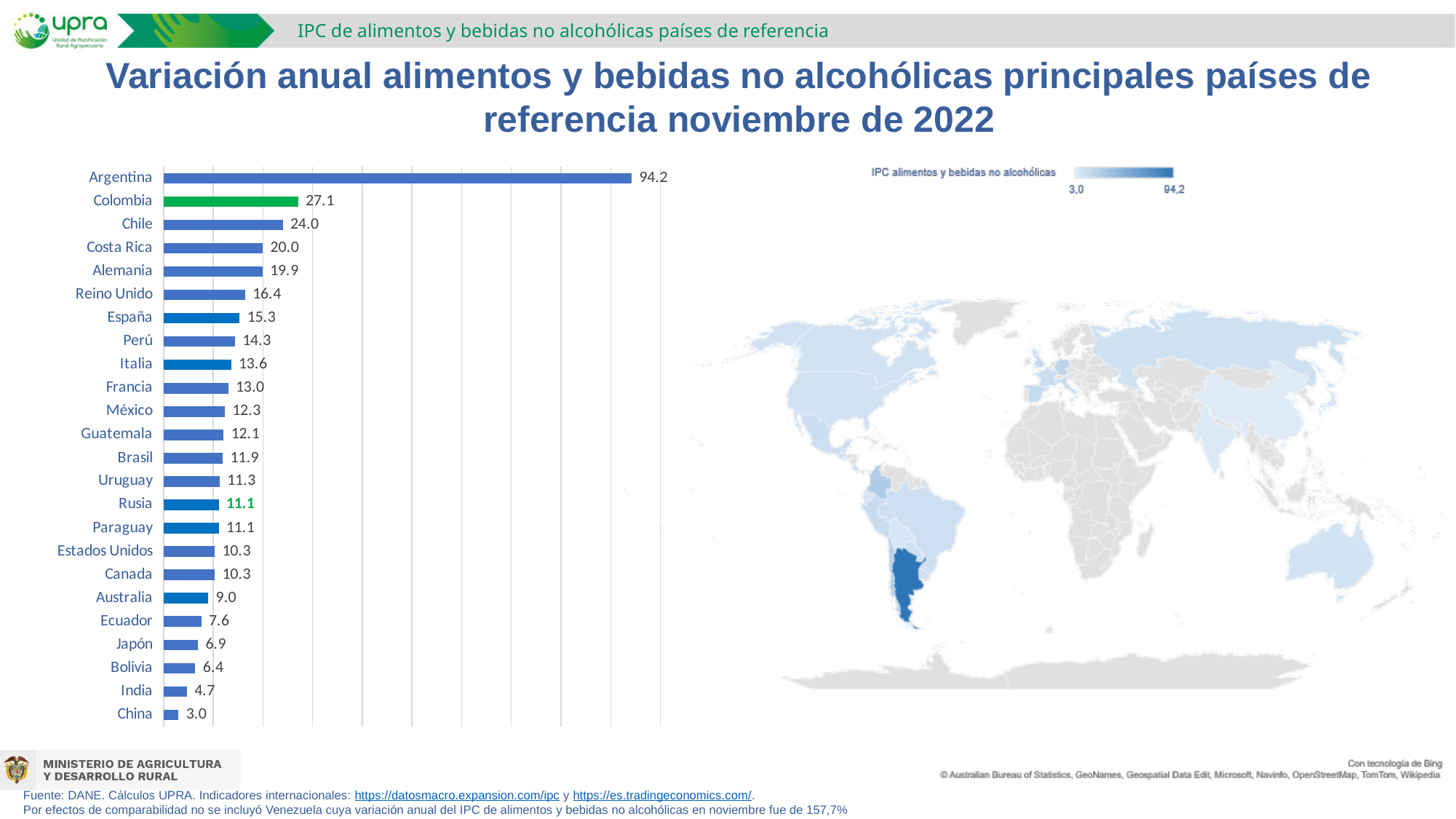
How many countries are shown in the bar chart? 24 In the bar chart, what is the difference between the values for Argentina and Colombia? 67.1 In the bar chart, which country's bar is coloured green instead of blue? Colombia In the bar chart, which has a larger value, India or Bolivia? Bolivia In the bar chart, what is the value for Colombia? 27.1 In the bar chart, what is the difference between the values for Chile and Costa Rica? 4.0 What kind of chart is the chart on the left of the slide? Bar chart In the bar chart, what is the value for Reino Unido? 16.4 In the bar chart, what is the value for Japón? 6.9 In the bar chart, which has a larger value, Perú or Brasil? Perú In the bar chart, which country has the lowest value? China In the bar chart, which country has the highest value? Argentina